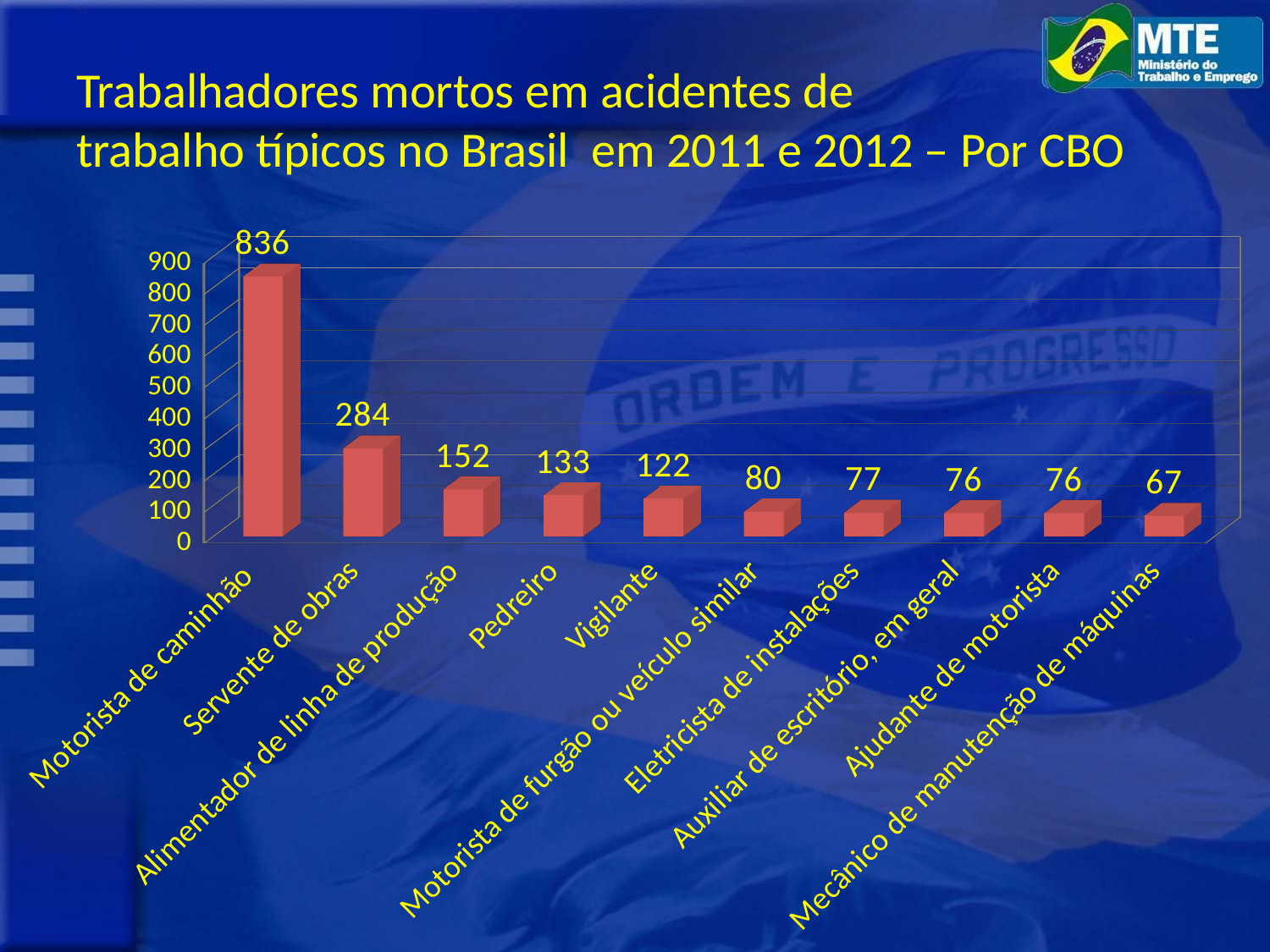
How many categories are shown on the x axis? 10 What kind of chart is shown on the slide? Bar chart Which category has the lowest value? Mecânico de manutenção de máquinas Do the values rise or fall from left to right along the x axis? Fall What is the difference between the values for Motorista de caminhão and Servente de obras? 552 What is the value for Pedreiro? 133 What is the value for Motorista de caminhão? 836 What is the value for Servente de obras? 284 Which category has the highest value? Motorista de caminhão What is the value for Vigilante? 122 What is the value for Mecânico de manutenção de máquinas? 67 Which is larger, the value for Alimentador de linha de produção or the value for Pedreiro? Alimentador de linha de produção